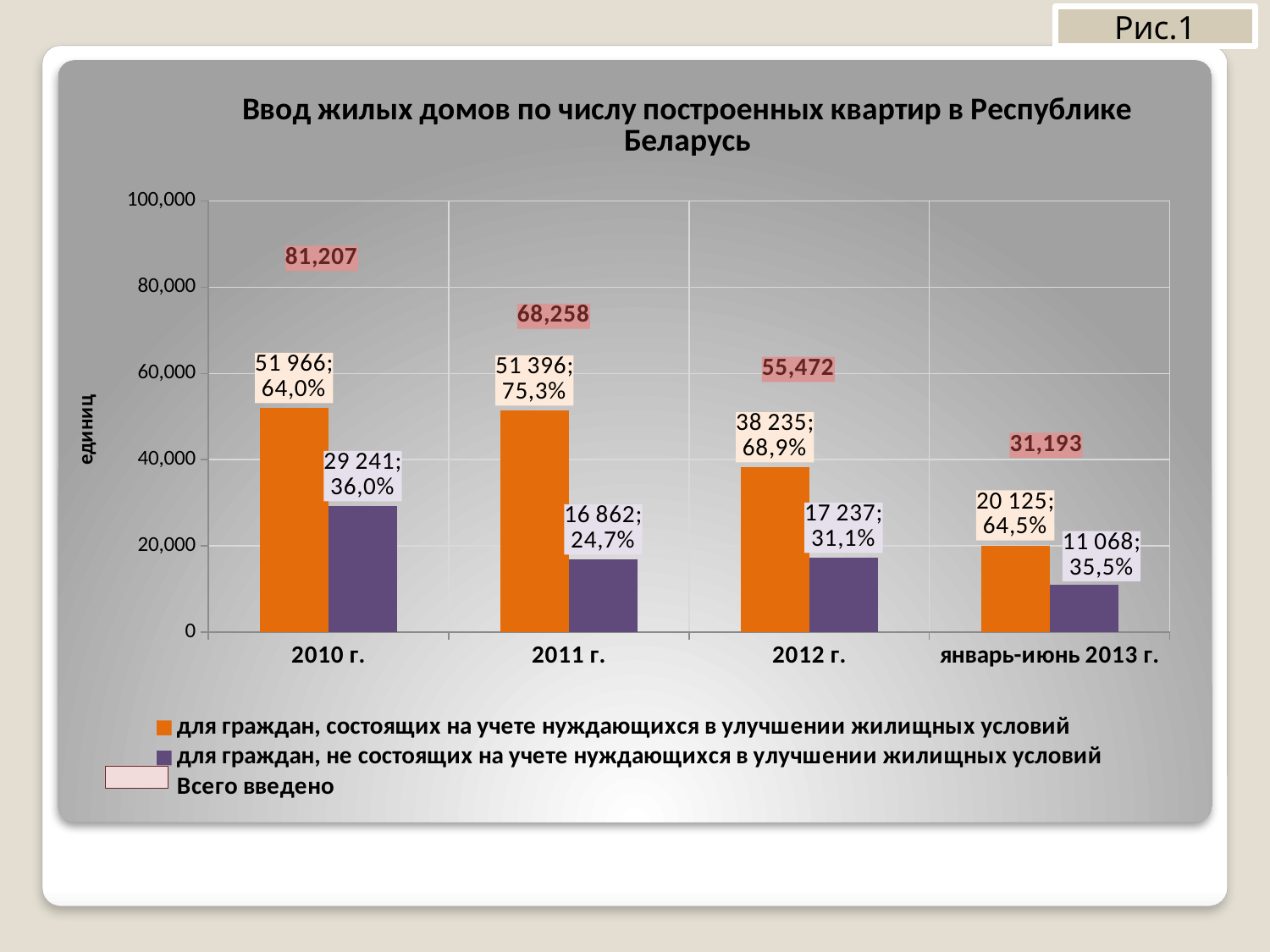
Which year has the highest total (Всего введено)? 2010 г. What kind of chart is shown on the slide? bar chart What is the value for citizens not registered as needing improved housing conditions (для граждан, не состоящих на учете) in 2011 г.? 16 862 Do the totals (Всего введено) rise or fall from 2010 г. to январь-июнь 2013 г.? fall Which category has the lowest value for citizens not registered as needing improved housing conditions (purple bars)? январь-июнь 2013 г. How many categories are shown on the x axis? 4 Which is larger in 2011 г.: the value for citizens registered as needing improved housing or the value for those not registered? для граждан, состоящих на учете нуждающихся в улучшении жилищных условий What is the difference between the orange and purple bars in 2012 г. (38 235 and 17 237)? 20 998 What is the value for citizens registered as needing improved housing conditions (для граждан, состоящих на учете) in 2010 г.? 51 966 Is the value for citizens registered as needing improved housing in 2010 г. greater or less than 40,000? greater What total (Всего введено) is shown for 2012 г.? 55,472 What percentage share is labelled for the orange bar in январь-июнь 2013 г.? 64,5%